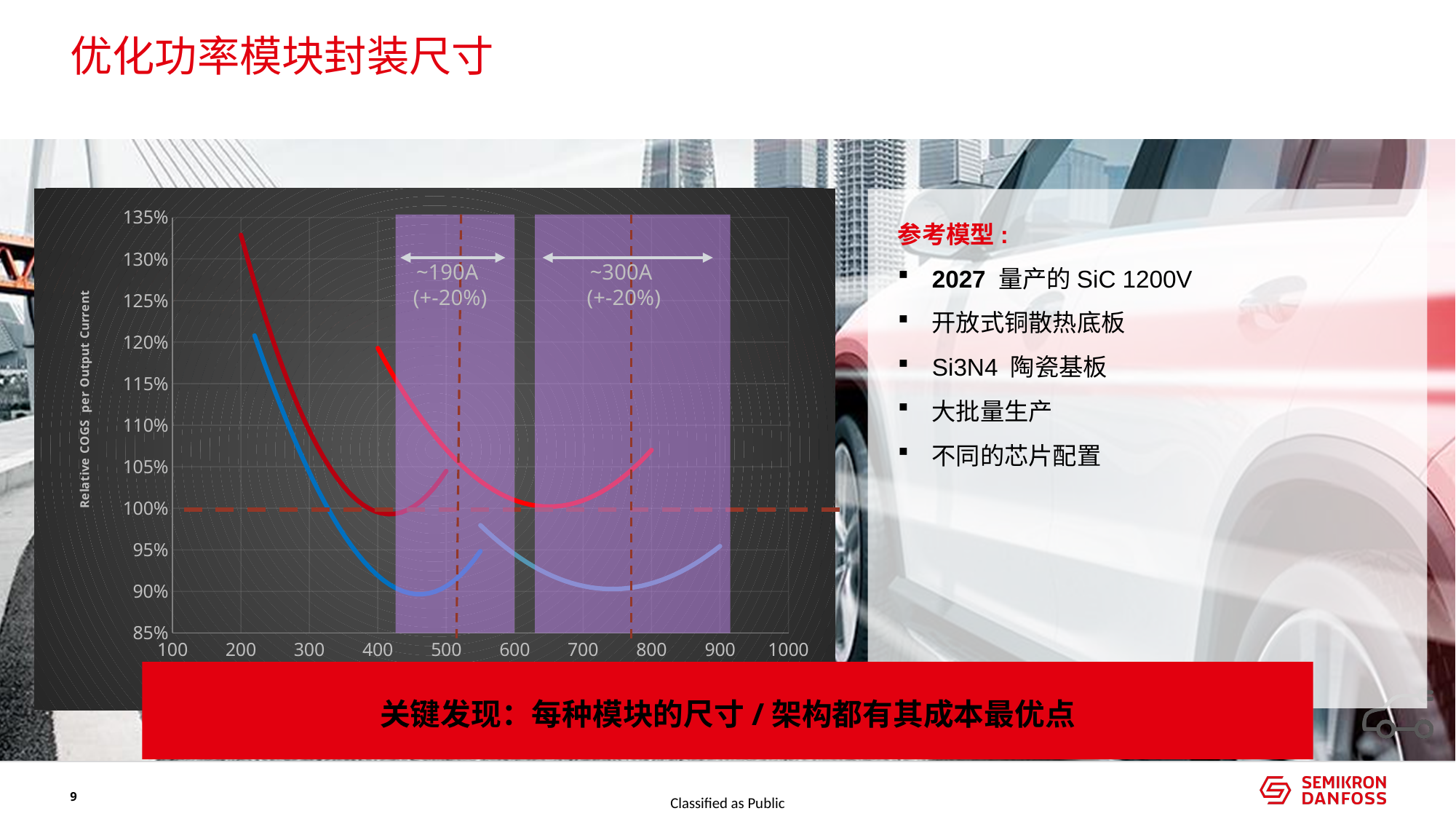
Which curve reaches lower values on the chart, the red curve or the blue curve? the blue curve Is the starting value of the red curve at x = 200 greater or less than 130%? greater How many purple shaded bands are drawn on the chart? 2 What is the lowest tick value shown on the y axis of the chart? 85% Is the lowest point of the blue curve greater or less than 95%? less What current value is labelled on the left purple shaded band of the chart? ~190A (+-20%) What kind of chart is shown on the slide? line chart What is the largest tick value shown on the x axis of the chart? 1000 At what y-axis level is the horizontal dashed red reference line drawn? 100% What is the label of the y axis of the chart? Relative COGS per Output Current Does the red curve rise or fall as x increases from 200 to 400? fall What is the highest tick value shown on the y axis of the chart? 135%